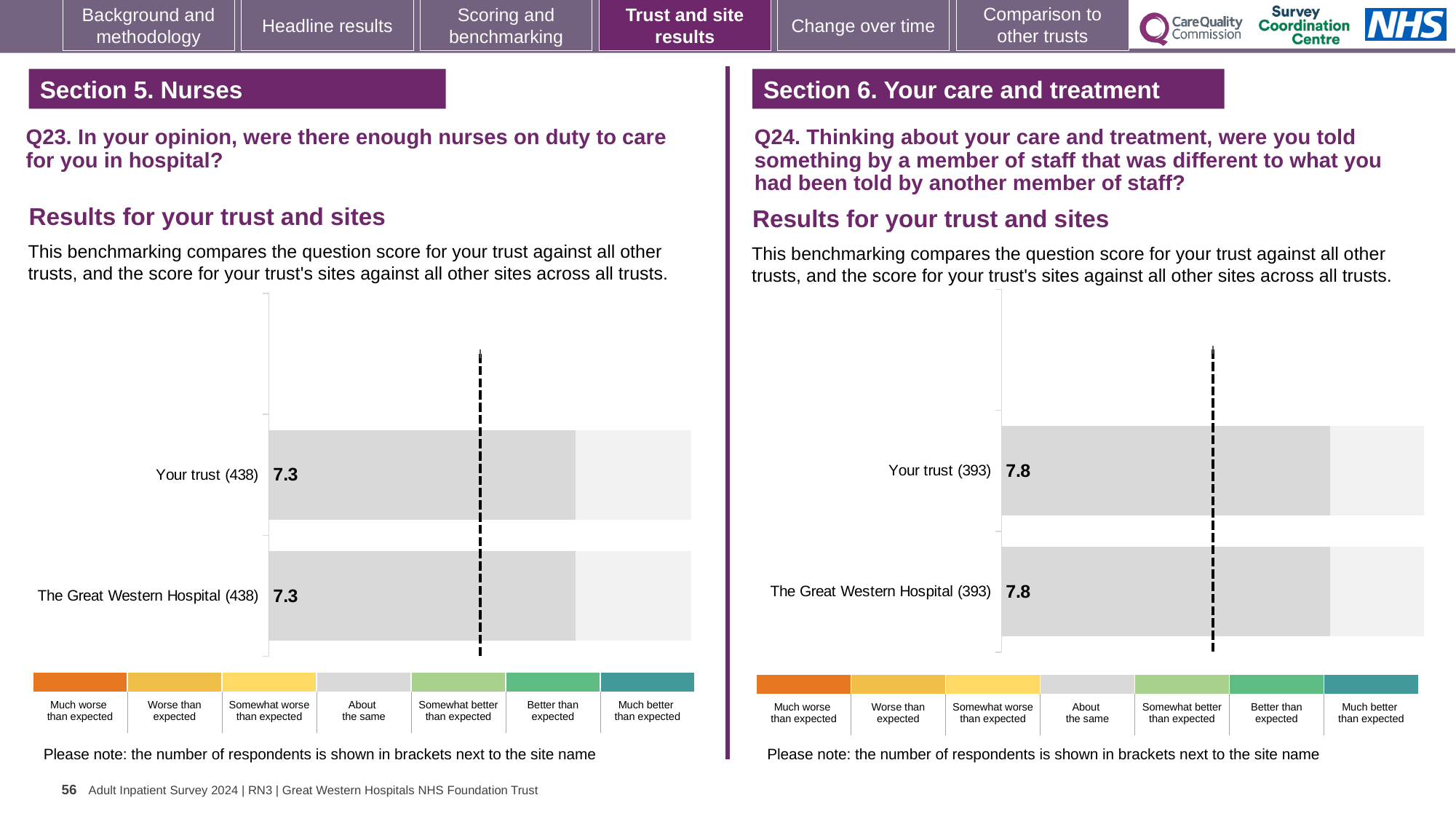
In the Q24 chart on the right, what is the score for The Great Western Hospital? 7.8 How many categories does the colour key below the Q23 chart on the left list? 7 In the Q24 chart on the right, how many respondents are shown in brackets next to The Great Western Hospital? 393 How many bars are plotted in the Q24 chart on the right? 2 Which section heading appears above the Q24 chart on the right? Section 6. Your care and treatment What kind of chart is used in the Q23 chart on the left? Bar chart In the Q23 chart on the left, what is the score for The Great Western Hospital? 7.3 In the Q23 chart on the left, what is the score for Your trust? 7.3 In the Q24 chart on the right, what is the score for Your trust? 7.8 Is the score for Your trust in the Q24 chart on the right greater or less than the score for Your trust in the Q23 chart on the left? greater In the Q23 chart on the left, how many respondents are shown in brackets next to Your trust? 438 In the Q23 chart on the left, what is the difference between the score for Your trust and the score for The Great Western Hospital? 0